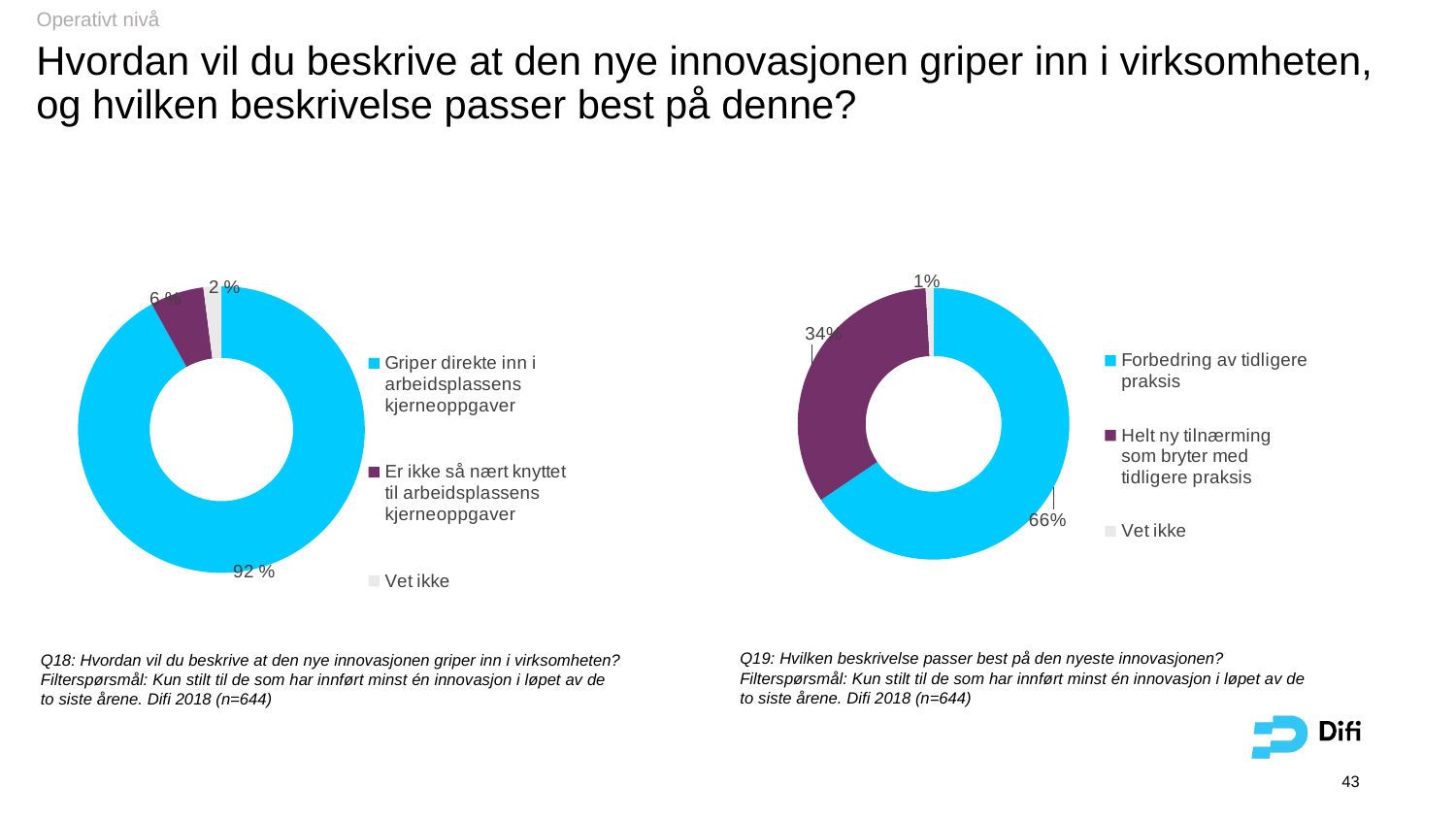
What type of chart is used on the left side of the slide (Q18)? Doughnut (pie) chart On the right chart (Q19), which category has the smallest share? Vet ikke How many categories does the legend of the right chart (Q19) list? 3 On the right chart (Q19), what is the difference in percentage points between 'Forbedring av tidligere praksis' and 'Helt ny tilnærming som bryter med tidligere praksis'? 32 percentage points On the left chart (Q18), what share of respondents answered 'Vet ikke'? 2 % On the left chart (Q18), which category has the largest share? Griper direkte inn i arbeidsplassens kjerneoppgaver On the left chart (Q18), what share of respondents answered 'Griper direkte inn i arbeidsplassens kjerneoppgaver'? 92 % On the left chart (Q18), what share of respondents answered 'Er ikke så nært knyttet til arbeidsplassens kjerneoppgaver'? 6 % On the right chart (Q19), what share of respondents answered 'Helt ny tilnærming som bryter med tidligere praksis'? 34% On the left chart (Q18), which is larger: 'Er ikke så nært knyttet til arbeidsplassens kjerneoppgaver' or 'Vet ikke'? Er ikke så nært knyttet til arbeidsplassens kjerneoppgaver On the right chart (Q19), what share of respondents answered 'Vet ikke'? 1% On the right chart (Q19), what share of respondents answered 'Forbedring av tidligere praksis'? 66%